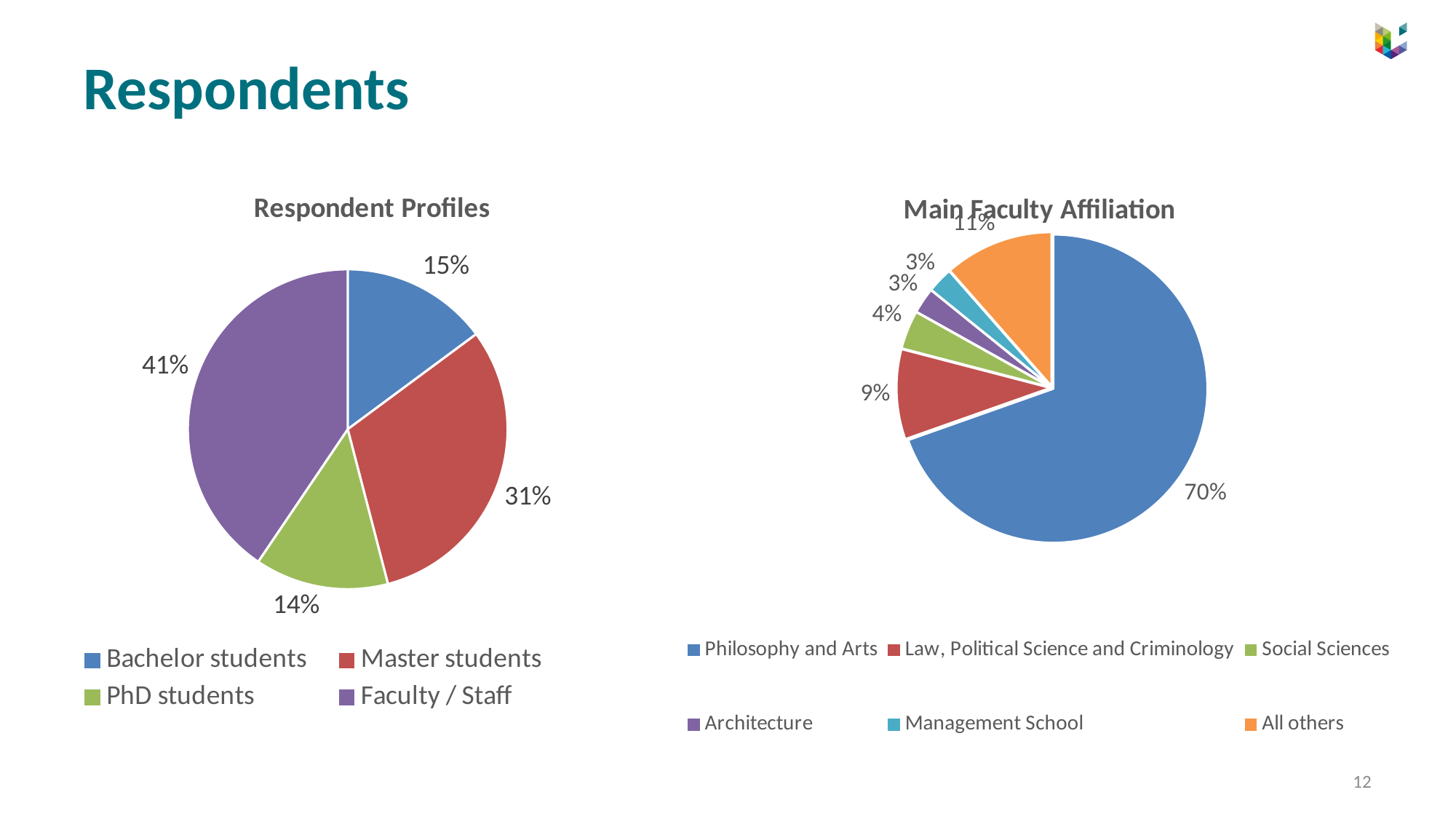
In the Respondent Profiles chart, what share of respondents are Master students? 31% In the Main Faculty Affiliation chart, which faculty has the largest share? Philosophy and Arts In the Respondent Profiles chart, what is the difference in percentage points between Master students and Bachelor students? 16 What type of chart is the Main Faculty Affiliation chart? Pie chart In the Respondent Profiles chart, what share of respondents are Faculty / Staff? 41% In the Respondent Profiles chart, which group has the largest share? Faculty / Staff In the Main Faculty Affiliation chart, what share is labelled All others? 11% In the Respondent Profiles chart, how many categories does the legend list? 4 In the Main Faculty Affiliation chart, which is larger: Social Sciences or All others? All others In the Main Faculty Affiliation chart, what share of respondents are from Philosophy and Arts? 70% In the Respondent Profiles chart, which group has the smallest share? PhD students In the Main Faculty Affiliation chart, what share of respondents are from Law, Political Science and Criminology? 9%